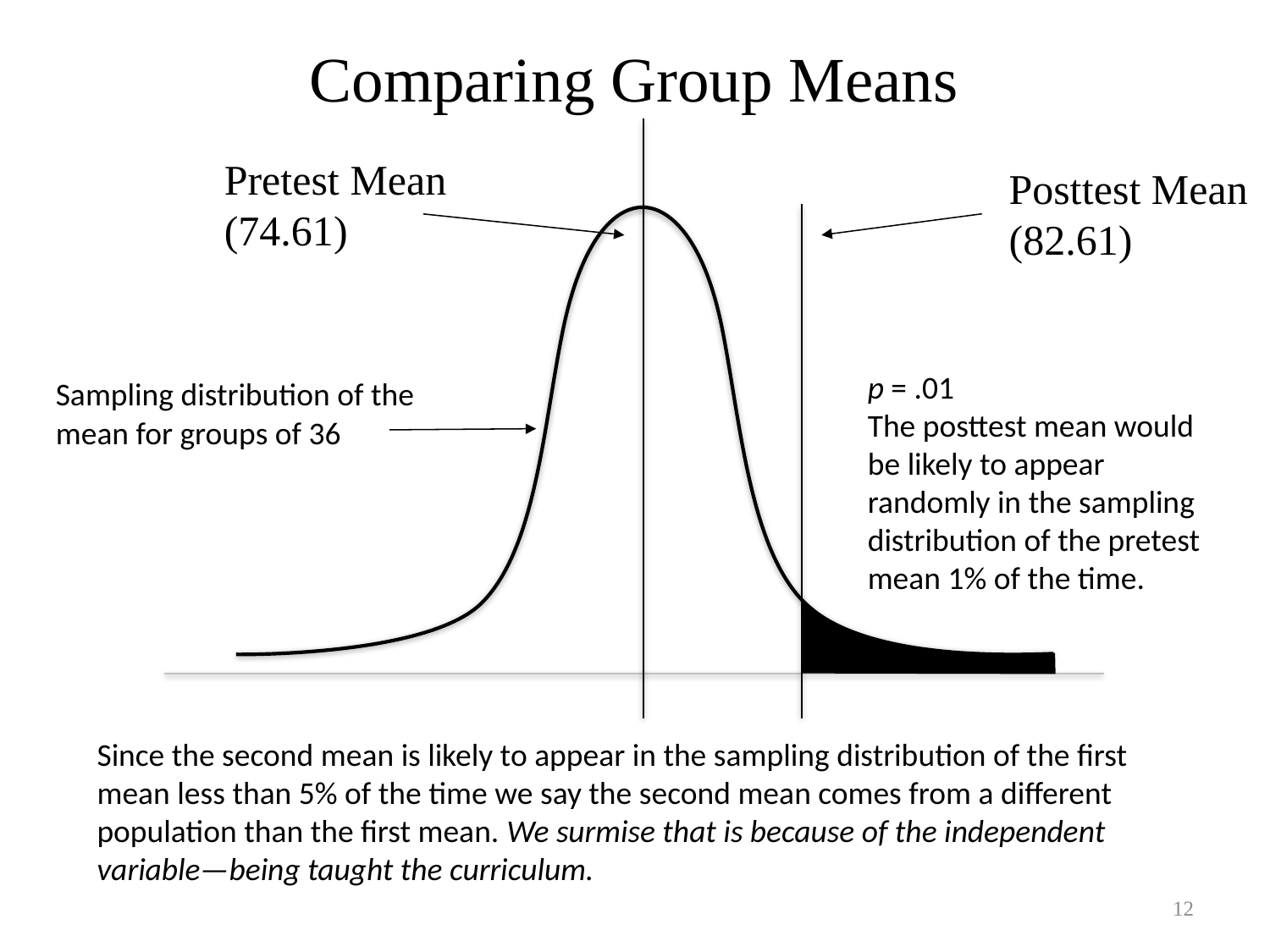
What is the difference between the posttest mean and the pretest mean? 8.00 On which side of the curve is the shaded tail region located? The right side What p value is printed on the slide? p = .01 Is the pretest mean greater or less than 80? less What is the title of the slide? Comparing Group Means What kind of chart is shown on the slide? A bell-shaped normal distribution curve Is the posttest mean greater or less than 80? greater What is the pretest mean shown on the chart? 74.61 According to the slide, what percentage of the time would the posttest mean appear randomly in the sampling distribution of the pretest mean? 1% Which is larger, the pretest mean or the posttest mean? Posttest mean What is the posttest mean shown on the chart? 82.61 What group size is the sampling distribution of the mean drawn for? 36